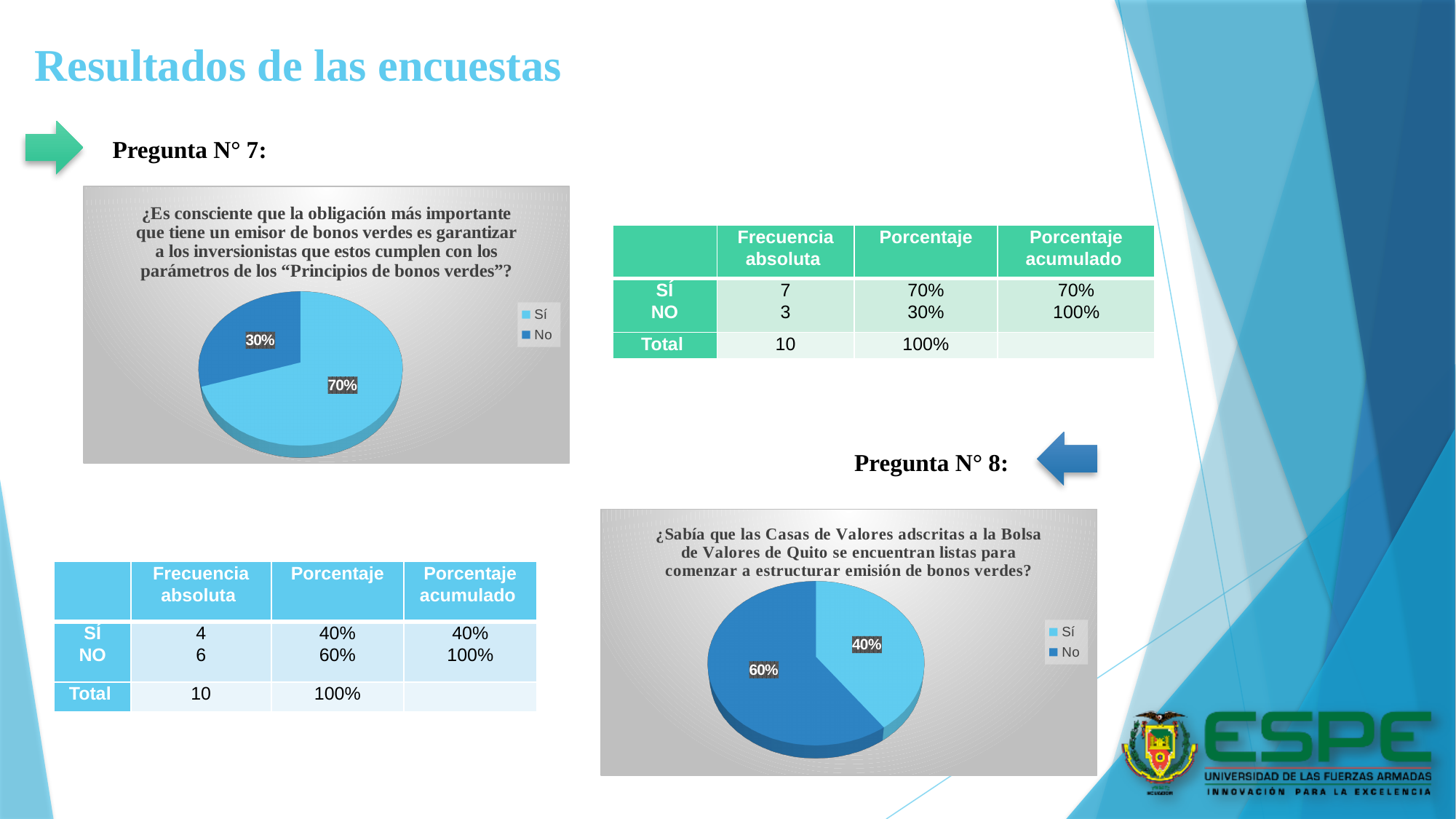
In the Pregunta N° 8 pie chart (bottom right), what percentage is shown for No? 60% In the Pregunta N° 7 pie chart (top left), how many entries does the legend list? 2 In the Pregunta N° 7 pie chart (top left), what is the difference in percentage points between Sí and No? 40 In the Pregunta N° 8 pie chart (bottom right), which is larger, Sí or No? No In the Pregunta N° 7 pie chart (top left), what percentage is shown for No? 30% In the Pregunta N° 8 pie chart (bottom right), which category has the smallest slice? Sí In the Pregunta N° 8 pie chart (bottom right), how many slices does the pie have? 2 What type of chart is used for Pregunta N° 7 (top left)? Pie chart In the Pregunta N° 7 pie chart (top left), which category has the largest slice? Sí In the Pregunta N° 7 pie chart (top left), what percentage is shown for Sí? 70% In the Pregunta N° 8 pie chart (bottom right), what percentage is shown for Sí? 40% In the Pregunta N° 8 pie chart (bottom right), what colour is the No slice? Dark blue